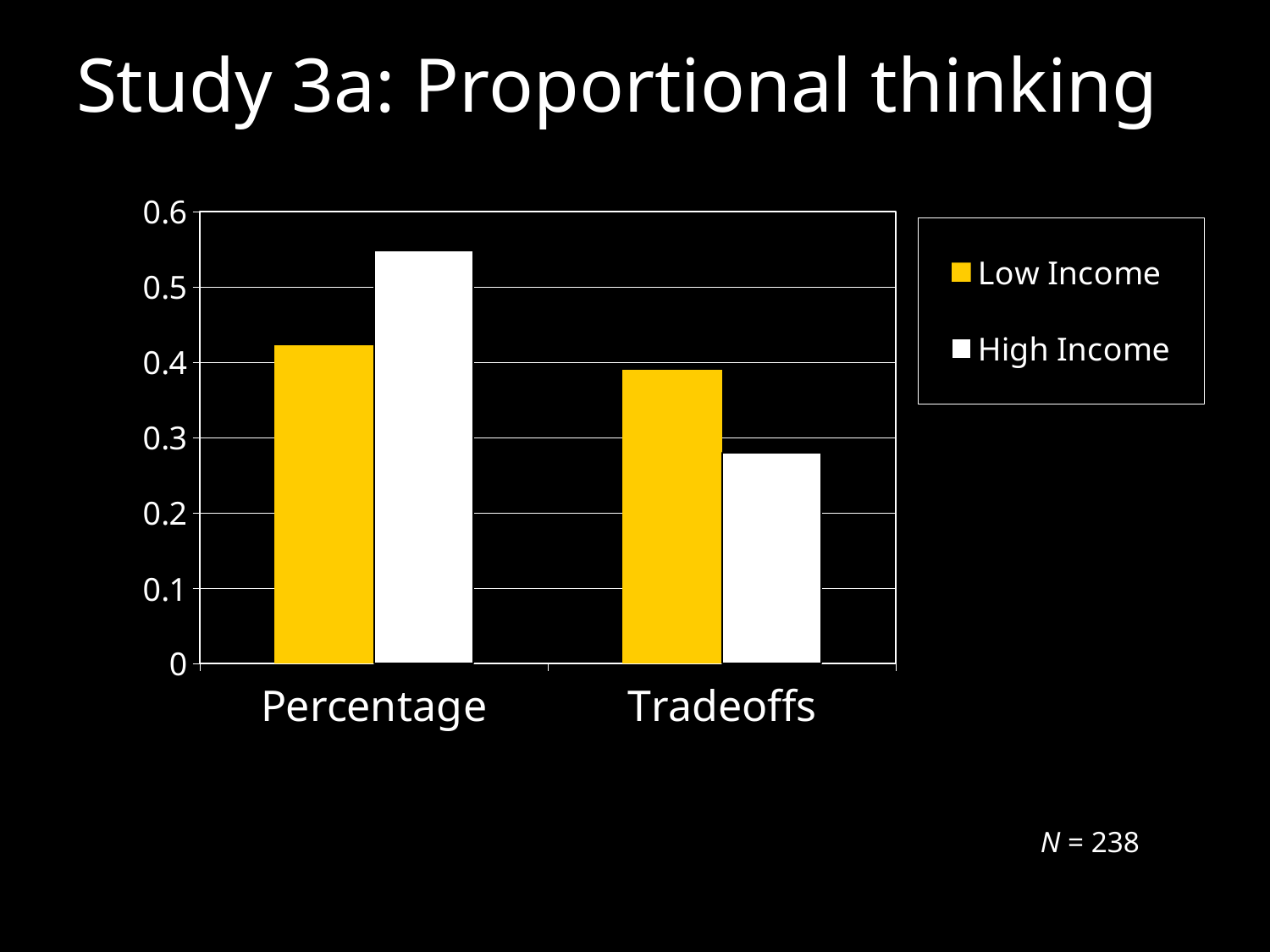
Is the High Income value for Percentage greater or less than 0.5? greater Which bar is the tallest in the chart? High Income for Percentage What kind of chart is shown on the slide? bar chart Which series is shown in yellow in the chart? Low Income For the Tradeoffs category, which series has the larger value, Low Income or High Income? Low Income What sample size (N) is noted on the slide? N = 238 How many categories are shown on the x axis of the chart? 2 Is the Low Income value for Tradeoffs greater or less than 0.3? greater Is the High Income value for Tradeoffs greater or less than 0.3? less For the Percentage category, which series has the larger value, Low Income or High Income? High Income How many series does the chart's legend list? 2 Which bar is the shortest in the chart? High Income for Tradeoffs